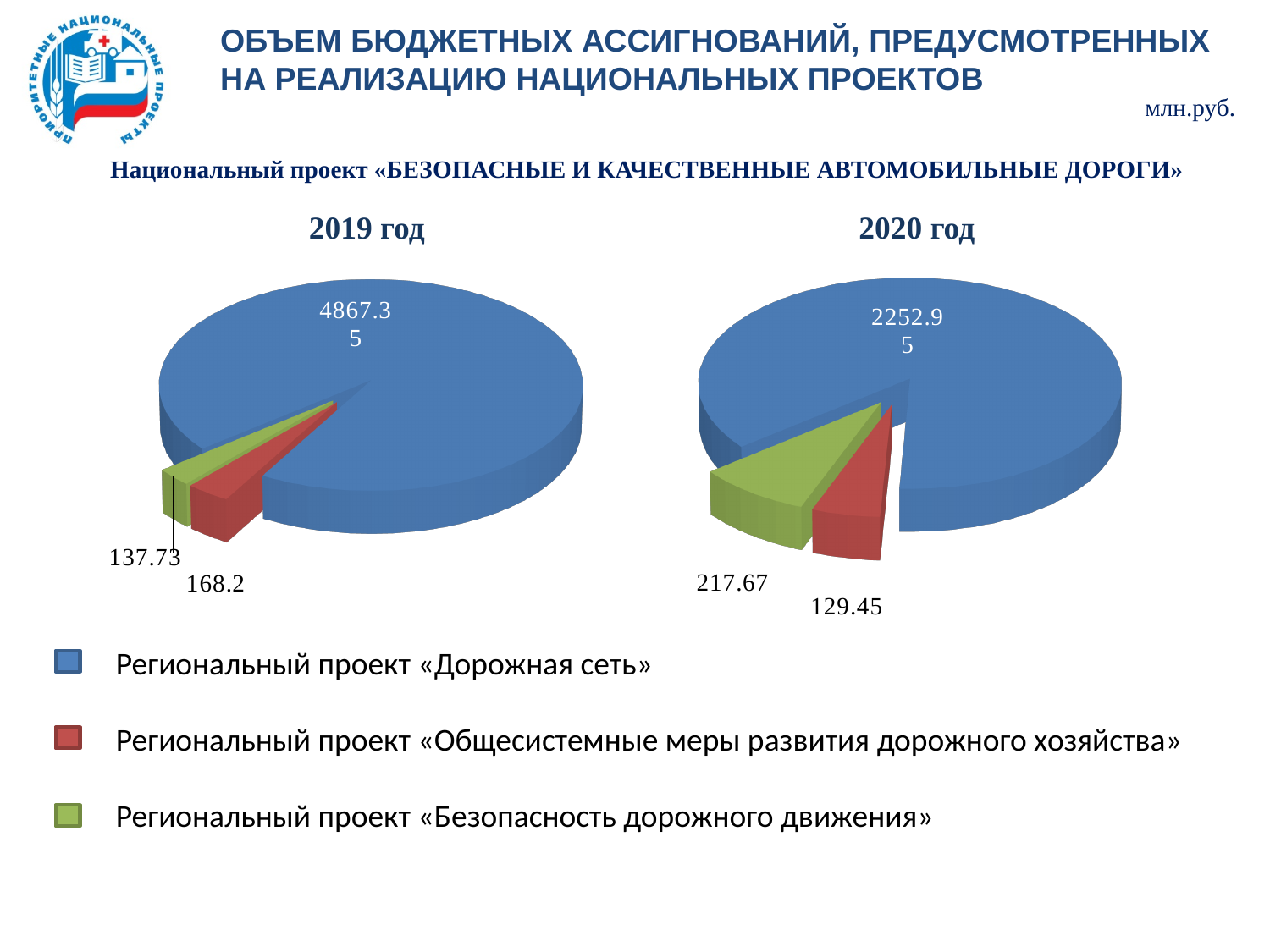
In the 2019 год chart, what is the value for Региональный проект «Безопасность дорожного движения»? 137.73 How many regional projects does the legend list? 3 In the 2019 год chart, which regional project has the largest slice? Региональный проект «Дорожная сеть» In the 2020 год chart, what is the difference between the values for «Безопасность дорожного движения» and «Общесистемные меры развития дорожного хозяйства»? 88.22 In the 2019 год chart, what is the value for Региональный проект «Дорожная сеть»? 4867.35 In the 2020 год chart, which regional project has the smallest slice? Региональный проект «Общесистемные меры развития дорожного хозяйства» In the 2020 год chart, what is the value for Региональный проект «Общесистемные меры развития дорожного хозяйства»? 129.45 In the 2020 год chart, what is the value for Региональный проект «Дорожная сеть»? 2252.95 In the 2020 год chart, what is the value for Региональный проект «Безопасность дорожного движения»? 217.67 In the 2019 год chart, what is the difference between the values for «Общесистемные меры развития дорожного хозяйства» and «Безопасность дорожного движения»? 30.47 What kind of charts are shown on the slide? Pie charts Which chart shows the larger value for Региональный проект «Дорожная сеть», 2019 год or 2020 год? 2019 год